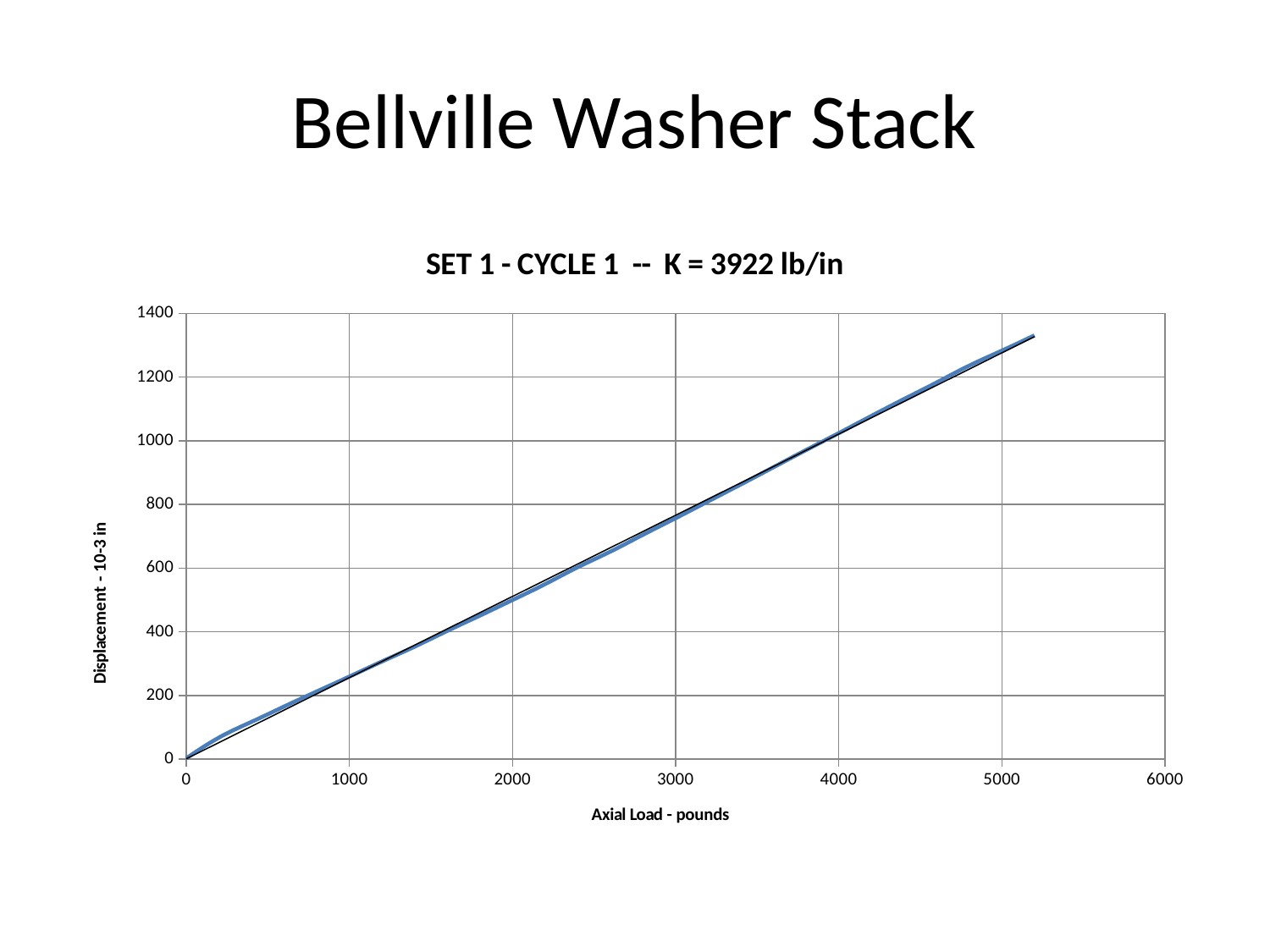
Does the displacement rise or fall as the axial load increases along the x axis? rise What is the title of the chart? SET 1 - CYCLE 1 -- K = 3922 lb/in Is the displacement at an axial load of 1000 pounds greater or less than 200? greater What kind of chart is shown on the slide? line chart What stiffness value K is stated in the chart title? 3922 lb/in Is the displacement at an axial load of 5000 pounds greater or less than 1200? greater Is the displacement at an axial load of 5000 pounds greater or less than 1400? less What is the highest value shown on the x axis? 6000 Is the displacement at an axial load of 3000 pounds larger than the displacement at 1000 pounds? yes